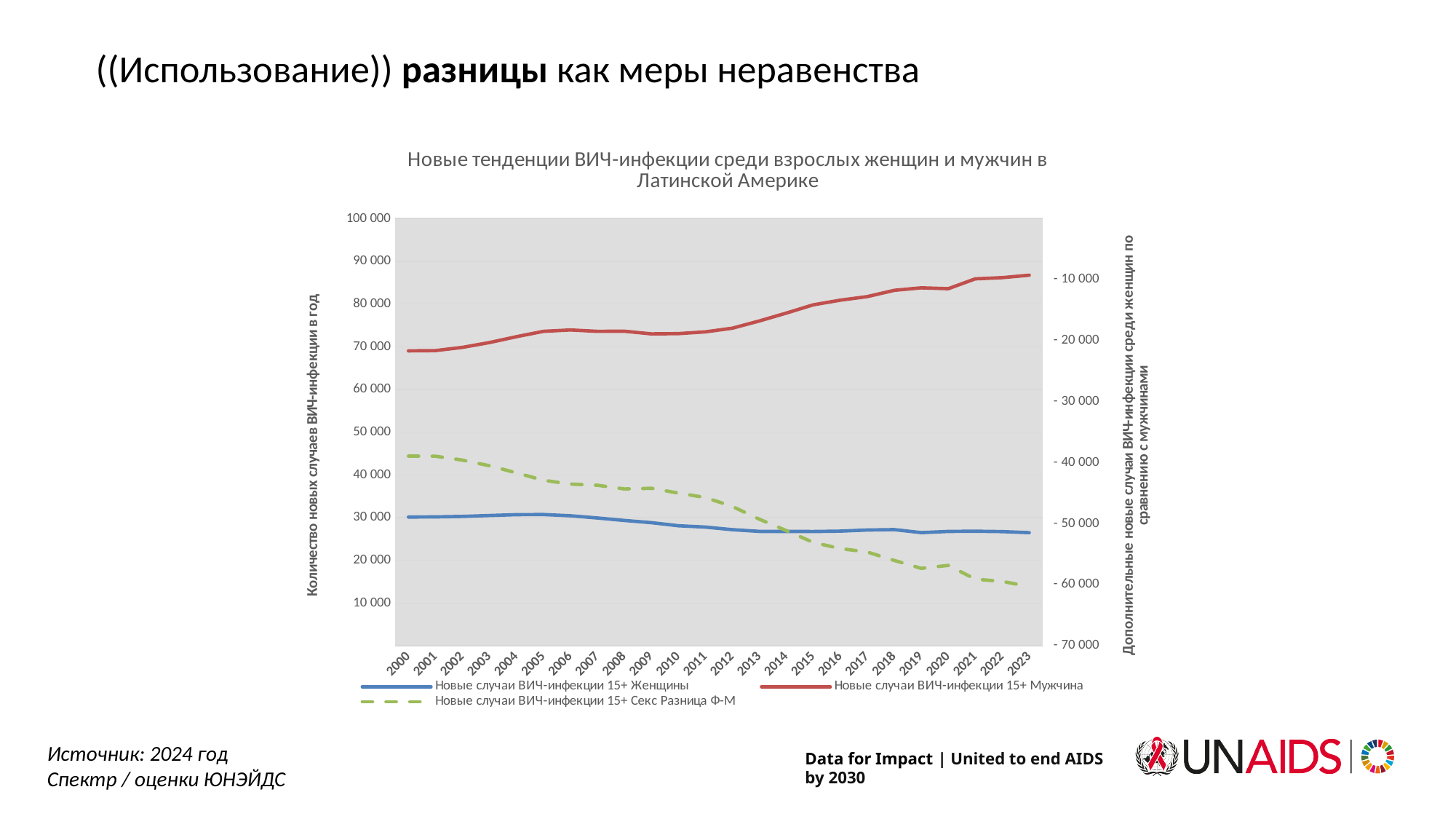
Is the value for 'Новые случаи ВИЧ-инфекции 15+ Мужчина' in 2000 greater or less than 60 000? greater Do the values for 'Новые случаи ВИЧ-инфекции 15+ Женщины' rise or fall from 2000 to 2023? Fall Do the values for 'Новые случаи ВИЧ-инфекции 15+ Мужчина' rise or fall from 2000 to 2023? Rise In 2010, which series has the larger value: 'Новые случаи ВИЧ-инфекции 15+ Мужчина' or 'Новые случаи ВИЧ-инфекции 15+ Женщины'? Новые случаи ВИЧ-инфекции 15+ Мужчина How many series does the legend list? 3 What is the first year shown on the x axis? 2000 What kind of chart is shown on the slide? Line chart How many years are plotted along the x axis? 24 Which series is drawn as a dashed line? Новые случаи ВИЧ-инфекции 15+ Секс Разница Ф-М What is the last year shown on the x axis? 2023 Is the value for 'Новые случаи ВИЧ-инфекции 15+ Женщины' in 2000 greater or less than 40 000? less Is the value for 'Новые случаи ВИЧ-инфекции 15+ Мужчина' in 2023 greater or less than 80 000? greater